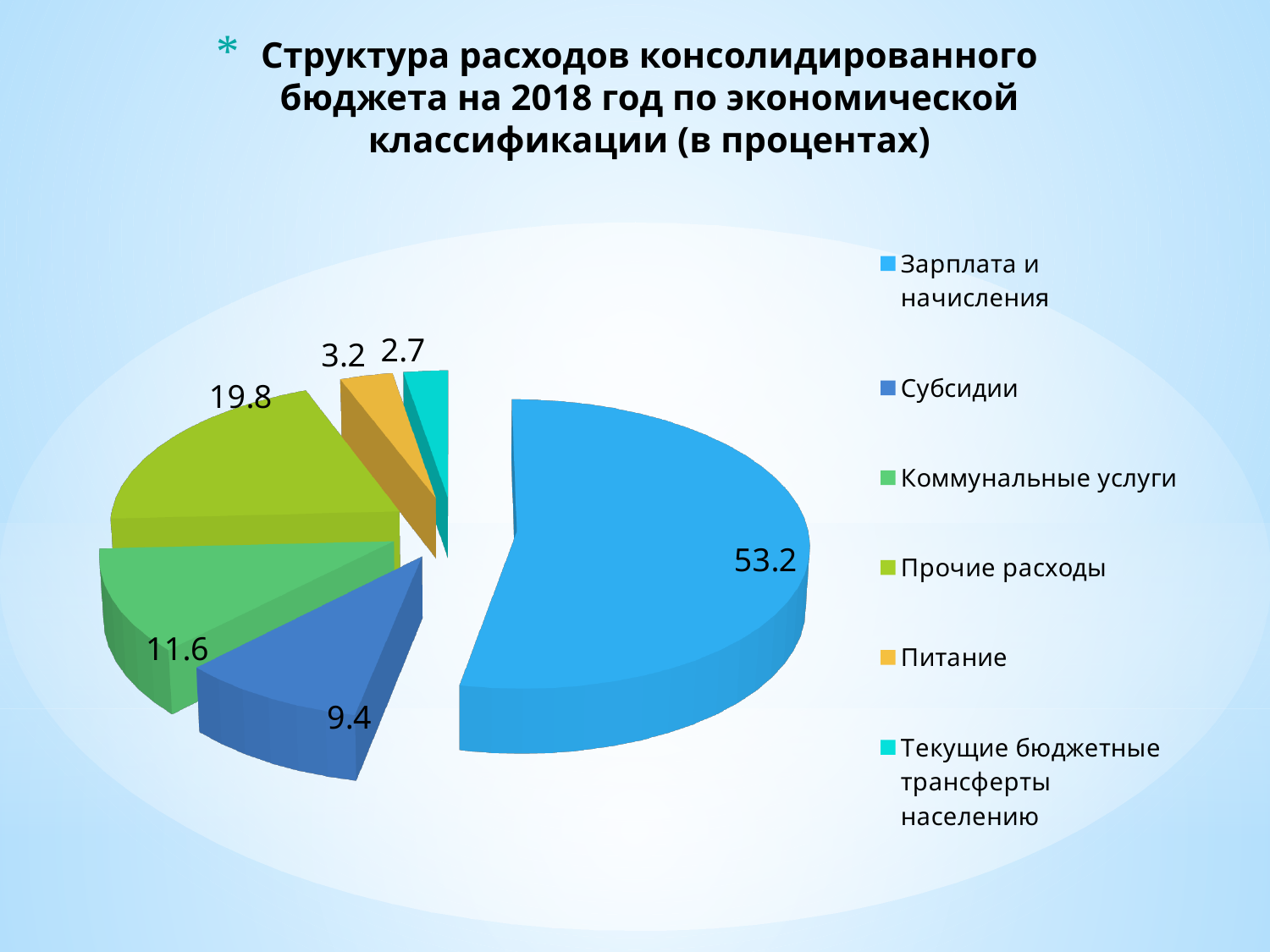
What is the difference between the values for Зарплата и начисления and Прочие расходы? 33.4 How many categories does the pie chart have? 6 What is the value for Прочие расходы? 19.8 What is the value for Текущие бюджетные трансферты населению? 2.7 What is the value for Коммунальные услуги? 11.6 Which category has the largest slice of the pie? Зарплата и начисления What is the value for Зарплата и начисления? 53.2 What colour is the slice for Питание? yellow Which category has the smallest slice of the pie? Текущие бюджетные трансферты населению Which is larger, the value for Субсидии or the value for Питание? Субсидии What kind of chart is shown on the slide? pie chart What is the difference between the values for Коммунальные услуги and Субсидии? 2.2